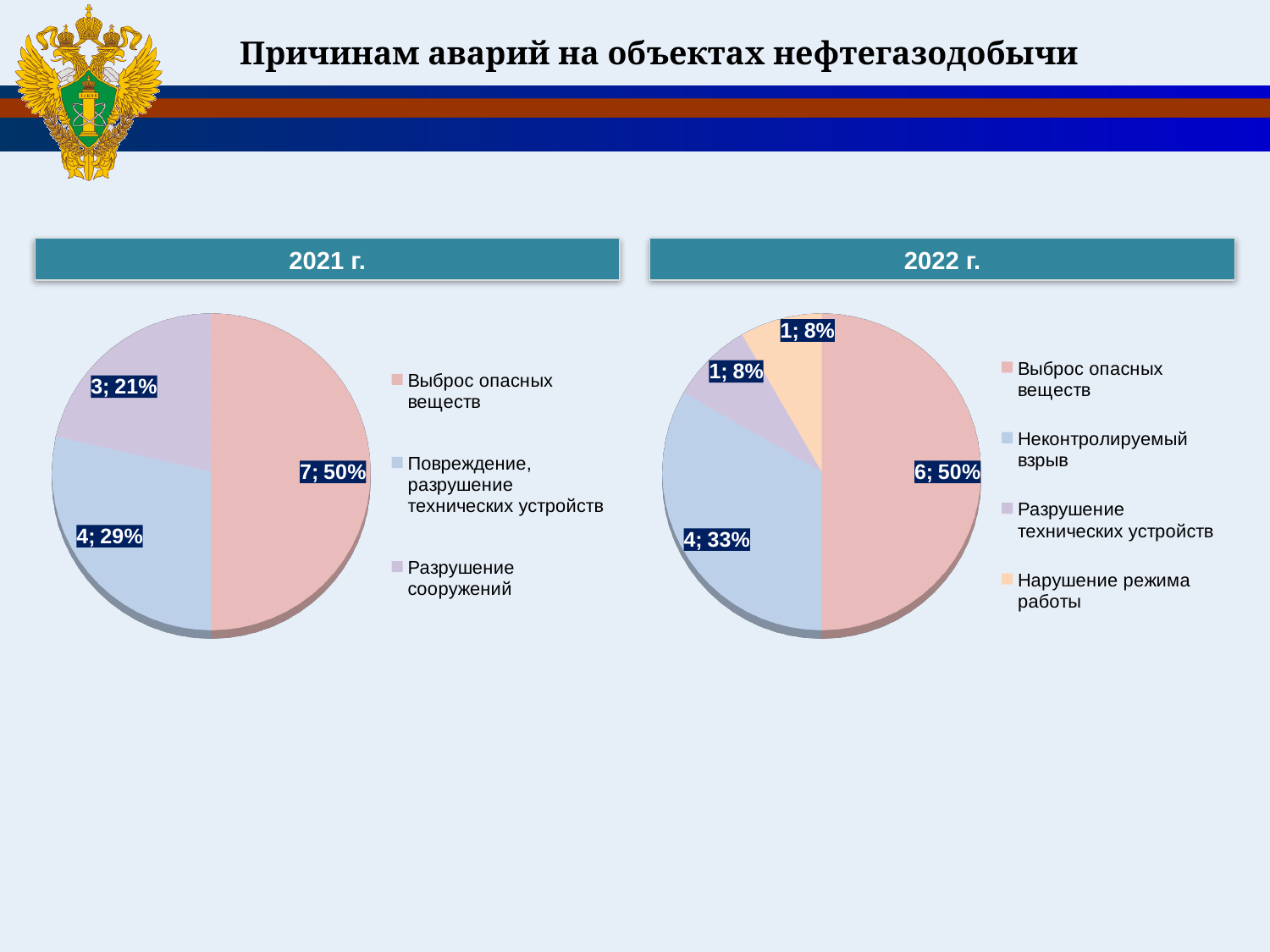
In the 2022 г. chart, what colour is the slice for Нарушение режима работы? Peach (light orange) In the 2022 г. chart, what share of the pie does Нарушение режима работы take? 8% In the 2022 г. chart, which category has the largest slice? Выброс опасных веществ In the 2022 г. chart, how many categories does the legend list? 4 What type of chart is used on this slide? Pie chart In the 2021 г. chart, how many categories does the legend list? 3 In the 2021 г. chart, what share of the pie does Повреждение, разрушение технических устройств take? 29% In the 2022 г. chart, what is the value shown for Неконтролируемый взрыв? 4; 33% In the 2021 г. chart, which category has the smallest slice? Разрушение сооружений Which is larger: the count for Выброс опасных веществ in the 2021 г. chart or in the 2022 г. chart? 2021 г. In the 2021 г. chart, what is the value shown for Выброс опасных веществ? 7; 50% In the 2021 г. chart, what is the difference between the counts for Выброс опасных веществ and Разрушение сооружений? 4